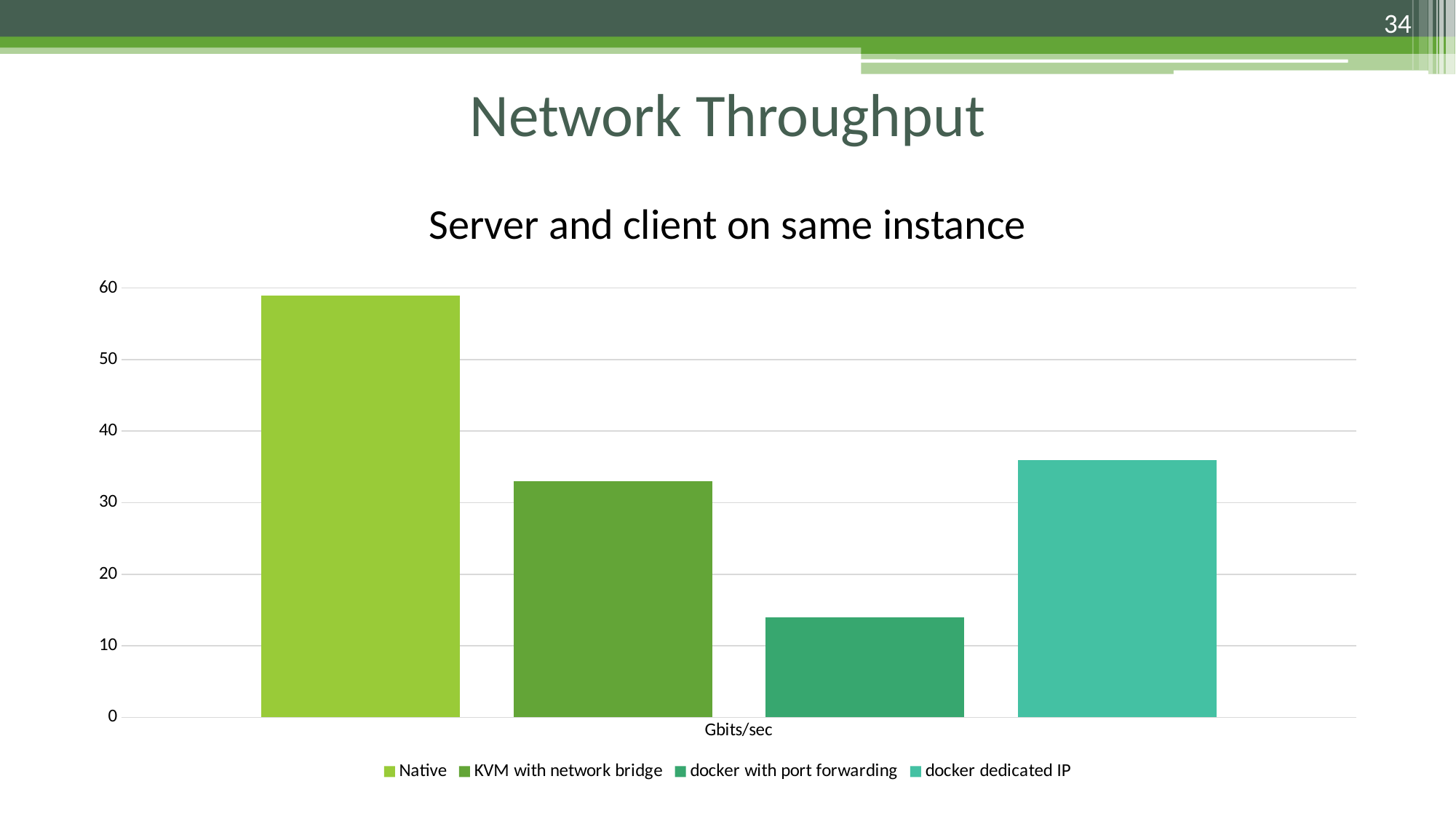
How many series does the legend list? 4 Is the value for docker with port forwarding greater or less than 20? less Which series has the lowest throughput? docker with port forwarding What is the title of the chart? Server and client on same instance Which is larger, the value for KVM with network bridge or the value for docker dedicated IP? docker dedicated IP What unit is shown on the x axis label of the chart? Gbits/sec Which series has the highest throughput? Native Is the value for Native greater or less than 50? greater Is the value for docker dedicated IP greater or less than 30? greater How many bars are plotted in the chart? 4 What kind of chart is shown on the slide? bar chart